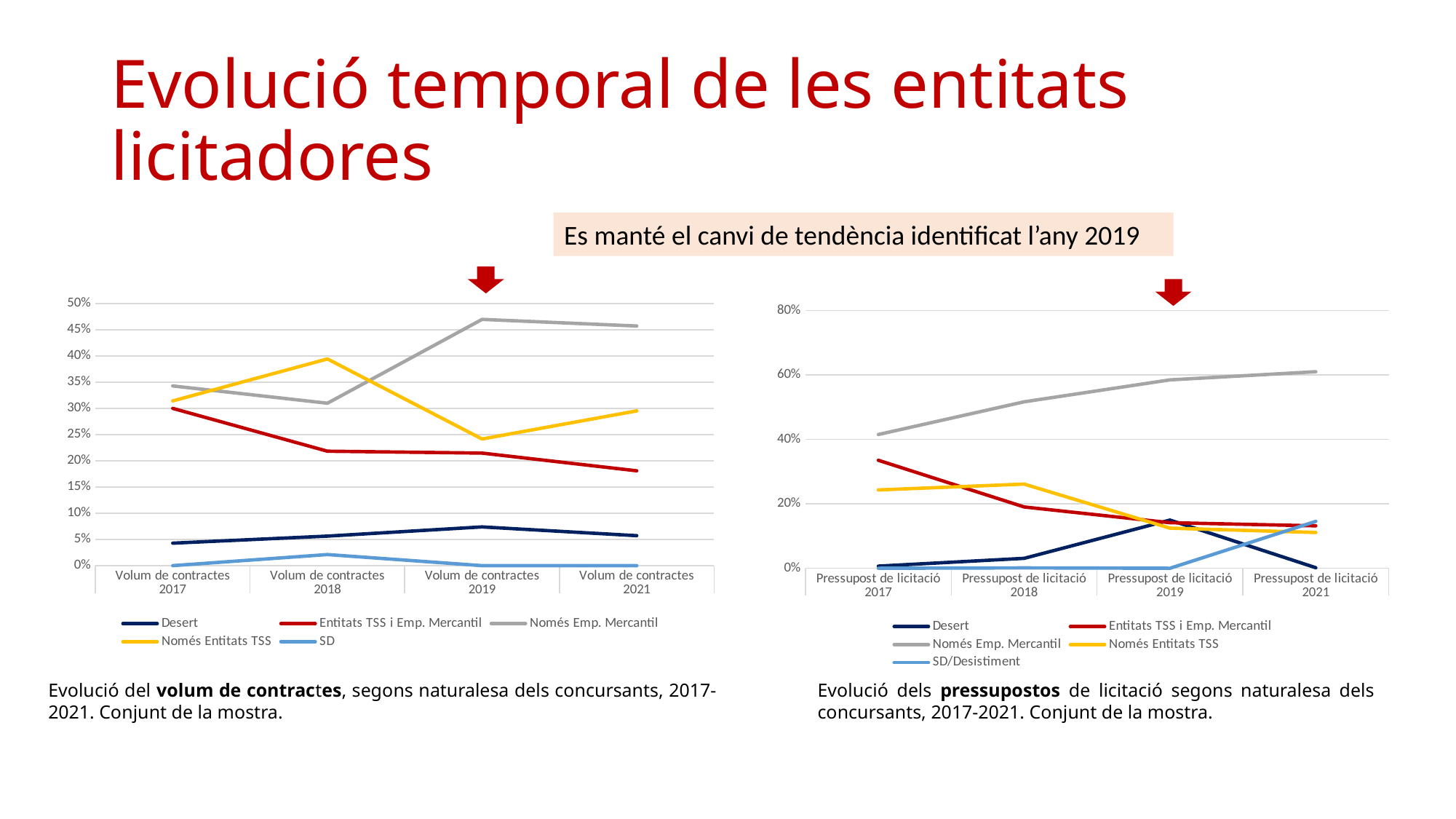
On the right chart (Pressupost de licitació), does the Només Emp. Mercantil series rise or fall from 2017 to 2021? rise On the right chart (Pressupost de licitació), is the value for Entitats TSS i Emp. Mercantil in 2017 greater or less than 20%? greater On the left chart (Volum de contractes), does the Entitats TSS i Emp. Mercantil series rise or fall from 2017 to 2021? fall On the left chart (Volum de contractes), is the value for Entitats TSS i Emp. Mercantil in 2021 greater or less than 20%? less On the right chart (Pressupost de licitació), which series has the highest value in 2021? Només Emp. Mercantil On the right chart (Pressupost de licitació), how many series does the legend list? 5 On the left chart (Volum de contractes), what kind of chart is it? line chart On the left chart (Volum de contractes), which series has the highest value in 2021? Només Emp. Mercantil On the left chart (Volum de contractes), is the value for Només Emp. Mercantil in 2019 greater or less than 45%? greater On the left chart (Volum de contractes), how many points are shown along the x axis? 4 On the left chart (Volum de contractes), how many series does the legend list? 5 On the left chart (Volum de contractes), in 2018, which is larger: Només Entitats TSS or Només Emp. Mercantil? Només Entitats TSS